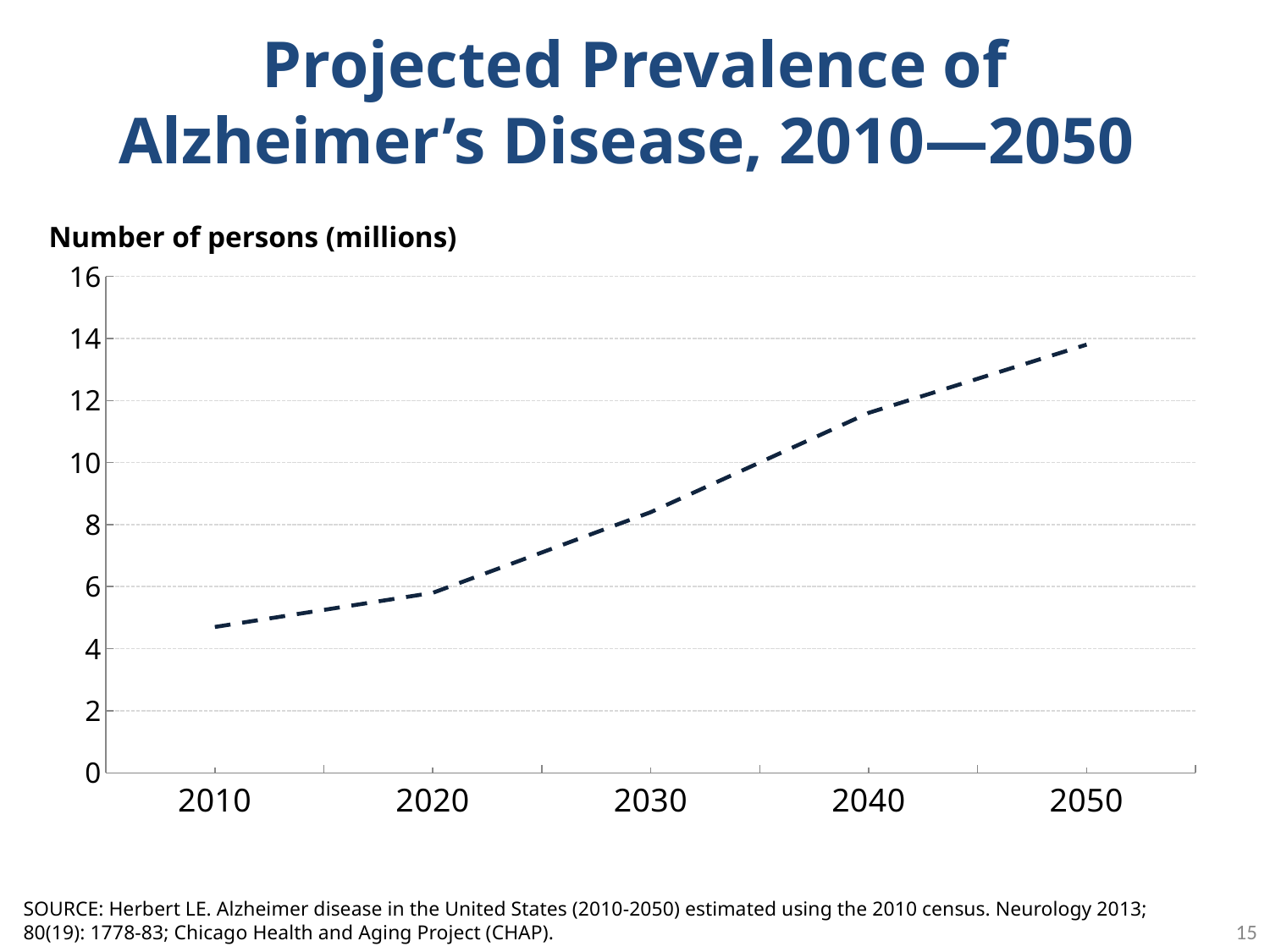
Is the value for 2010 greater or less than 6 million? less Is the value for 2050 greater or less than 12 million? greater What kind of chart is shown on the slide? line chart Is the value for 2020 greater or less than 4 million? greater Which year shown on the x axis has the highest projected number of persons? 2050 How many years are labeled on the x axis of the chart? 5 Which year shown on the x axis has the lowest projected number of persons? 2010 Does the projected number of persons with Alzheimer's disease rise or fall from 2010 to 2050? rise What unit is the y axis of the chart measured in, according to the axis label? Number of persons (millions) Which year has a larger projected number of persons, 2020 or 2040? 2040